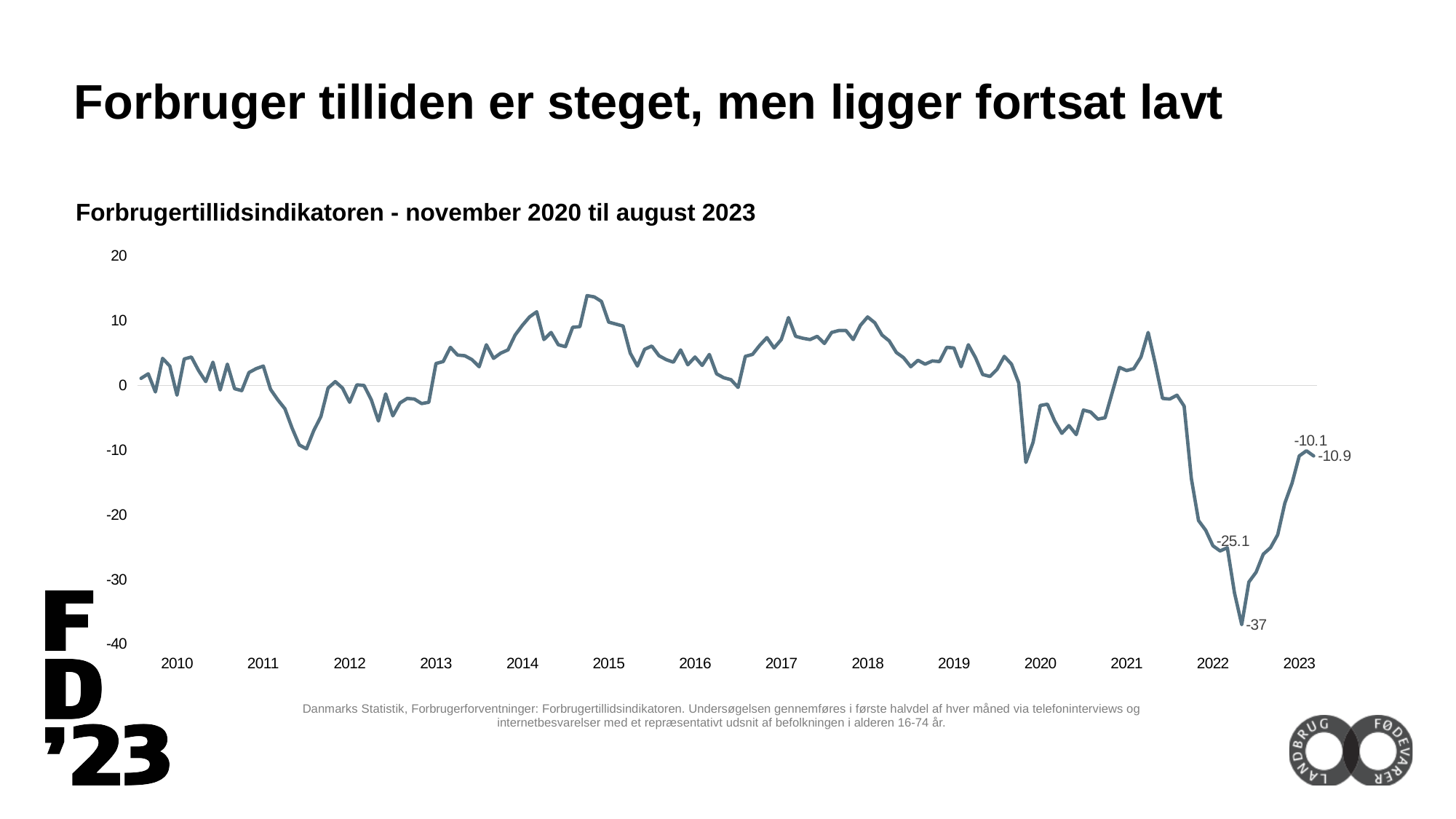
Does the line rise or fall from its low point of -37 in 2022 to the end of the chart in 2023? rise What is the value of the last data point on the line, at the right end of the chart? -10.9 What is the difference between the labelled values -10.1 and -10.9? 0.8 Which labelled value is larger, -25.1 or -37? -25.1 What is the title of the chart? Forbrugertillidsindikatoren - november 2020 til august 2023 What is the difference between the labelled values -25.1 and -37? 11.9 Is the peak value of the line around 2015 greater or less than 10? greater What is the value of the labelled point just before the final point, in 2023? -10.1 What is the lowest value labelled on the line, reached in 2022? -37 What kind of chart is shown on the slide? line chart How many lines (series) are plotted on the chart? 1 What is the labelled value of the local low point in early 2022, before the line drops to -37? -25.1